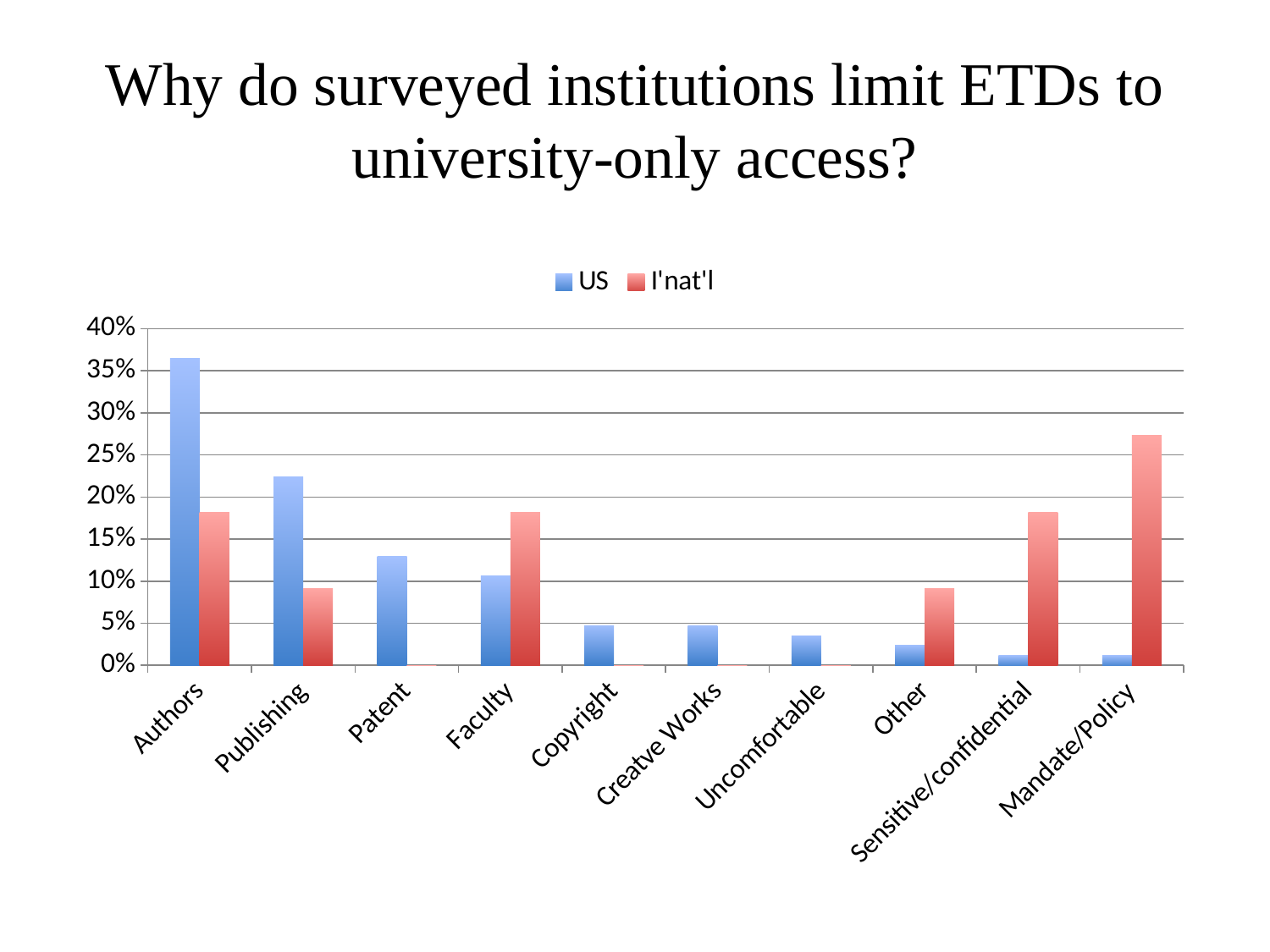
Which category has the highest value for the I'nat'l series? Mandate/Policy Is the US value for Patent greater or less than 10%? greater How many categories are shown on the x axis? 10 What kind of chart is shown on the slide? bar chart For Faculty, which series has the larger value, US or I'nat'l? I'nat'l How many series does the legend list? 2 Which category has the highest value for the US series? Authors Is the US value for Copyright greater or less than 10%? less Is the I'nat'l value for Mandate/Policy greater or less than 25%? greater For Publishing, which series has the larger value, US or I'nat'l? US Which colour represents the I'nat'l series in the legend? red